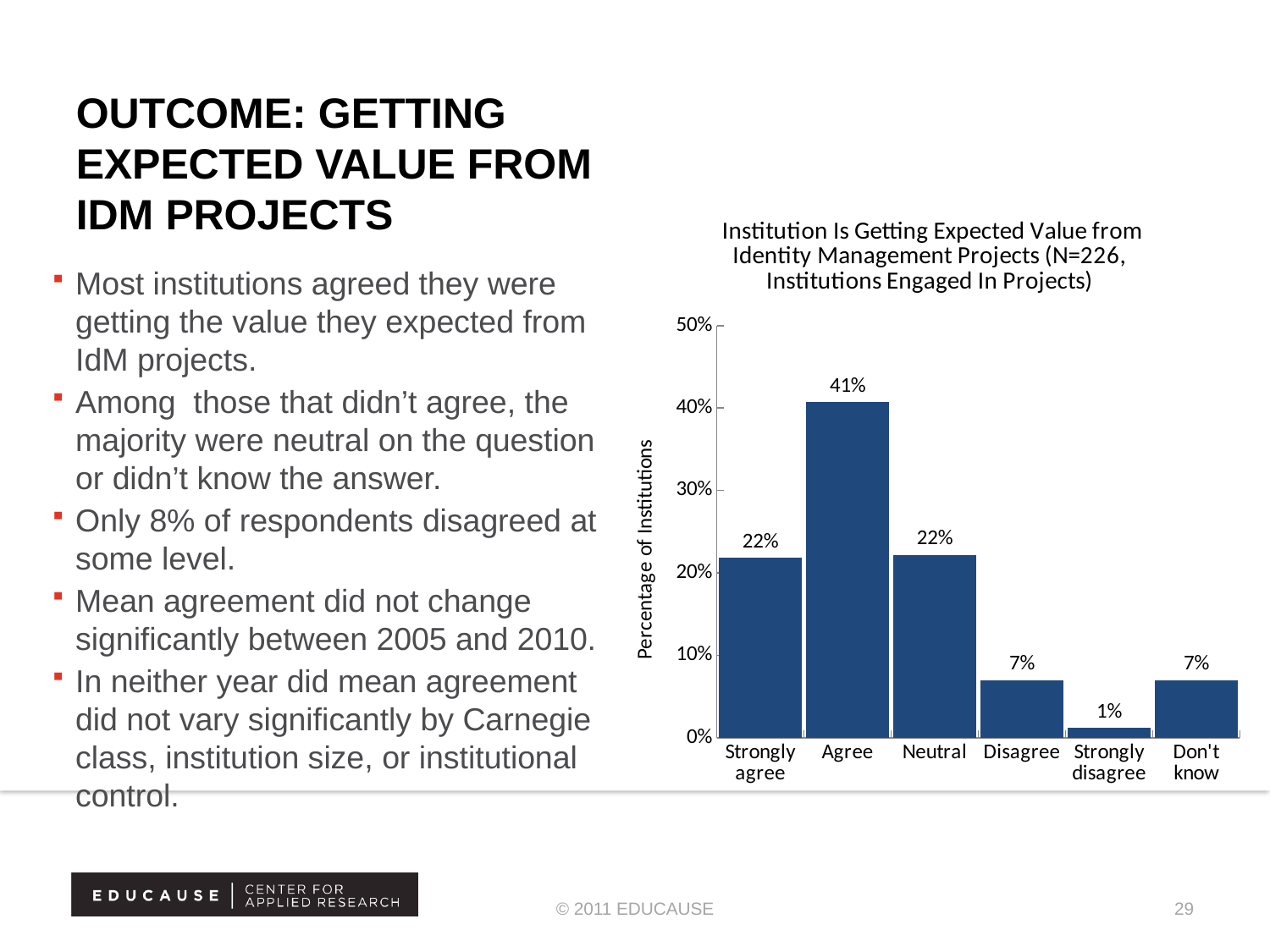
What percentage of institutions responded "Strongly disagree"? 1% What is the label of the y axis of the chart? Percentage of Institutions How many response categories are shown on the x axis? 6 What percentage of institutions responded "Don't know"? 7% What percentage of institutions responded "Agree"? 41% Which response category has the highest percentage of institutions? Agree What is the difference in percentage points between "Agree" and "Strongly agree"? 19 What kind of chart is shown on the slide? Bar chart What is the difference in percentage points between "Disagree" and "Strongly disagree"? 6 Is the value for "Agree" greater or less than 40%? greater Which is larger, the value for "Neutral" or the value for "Disagree"? Neutral Which response category has the lowest percentage of institutions? Strongly disagree